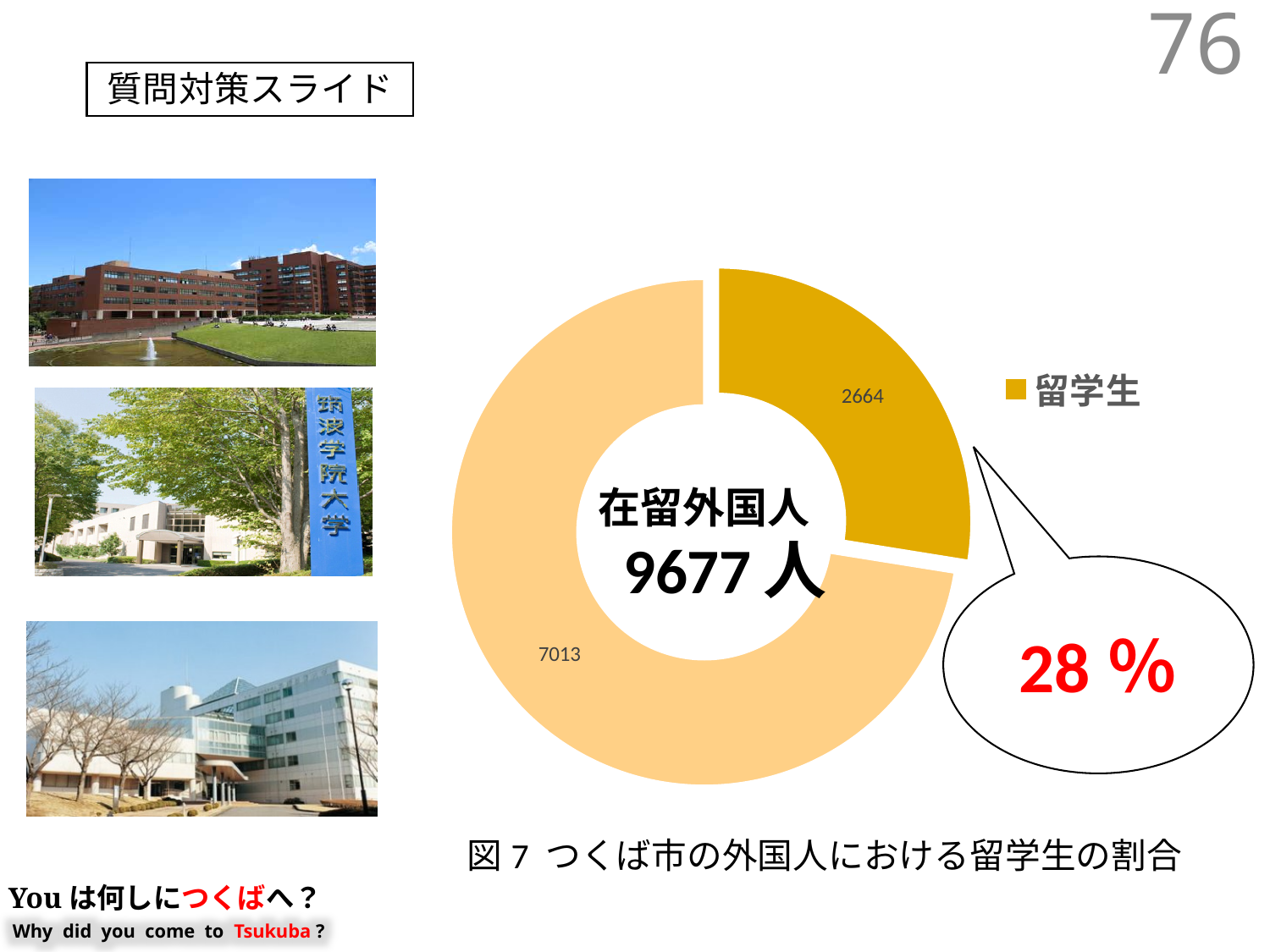
How many entries does the chart's legend list? 1 What total number of 在留外国人 is printed in the centre of the chart? 9677 人 What value is shown for the 留学生 slice of the chart? 2664 How many slices does the chart have? 2 What value is shown on the larger, light-orange slice of the chart? 7013 What is the figure caption printed below the chart? 図7 つくば市の外国人における留学生の割合 What is the only entry shown in the chart's legend? 留学生 What kind of chart is shown on the slide? Doughnut (pie) chart Which slice of the chart is the smallest? 留学生 (2664) According to the callout, what share of the chart does the 留学生 slice represent? 28 % Which slice is larger: the one labelled 2664 or the one labelled 7013? 7013 What is the difference between the two slice values, 7013 and 2664? 4349